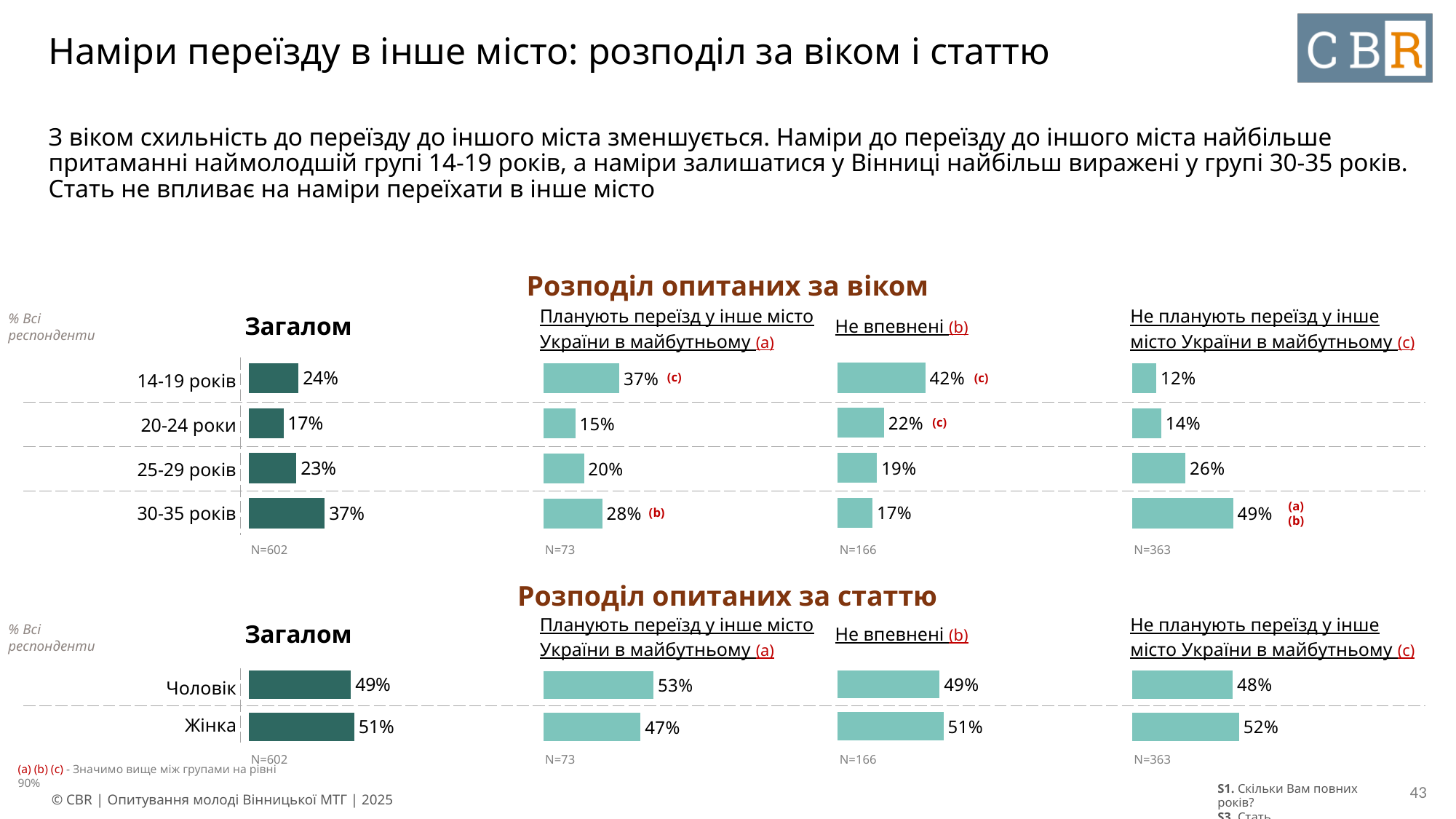
In the 'Розподіл опитаних за віком' chart, what is the value for 14-19 років in the 'Загалом' column? 24% What is the N shown under the 'Не впевнені' column in the 'Розподіл опитаних за віком' chart? N=166 In the 'Розподіл опитаних за статтю' chart, what is the difference between Чоловік and Жінка in the 'Планують переїзд у інше місто України в майбутньому' column? 6% In the 'Розподіл опитаних за віком' chart, which age group has the highest value in the 'Планують переїзд у інше місто України в майбутньому' column? 14-19 років What type of chart is used on this slide? Bar chart In the 'Розподіл опитаних за статтю' chart, what is the value for Чоловік in the 'Не планують переїзд у інше місто України в майбутньому' column? 48% How many age groups are shown in the 'Розподіл опитаних за віком' chart? 4 In the 'Розподіл опитаних за статтю' chart, what is the value for Жінка in the 'Планують переїзд у інше місто України в майбутньому' column? 47% In the 'Розподіл опитаних за віком' chart, what is the difference between the 'Не впевнені' values for 14-19 років and 20-24 роки? 20% In the 'Розподіл опитаних за віком' chart, which age group has the lowest value in the 'Не впевнені' column? 30-35 років In the 'Розподіл опитаних за віком' chart, which is larger in the 'Загалом' column: 25-29 років or 30-35 років? 30-35 років In the 'Розподіл опитаних за віком' chart, what is the value for 30-35 років in the 'Не планують переїзд у інше місто України в майбутньому' column? 49%